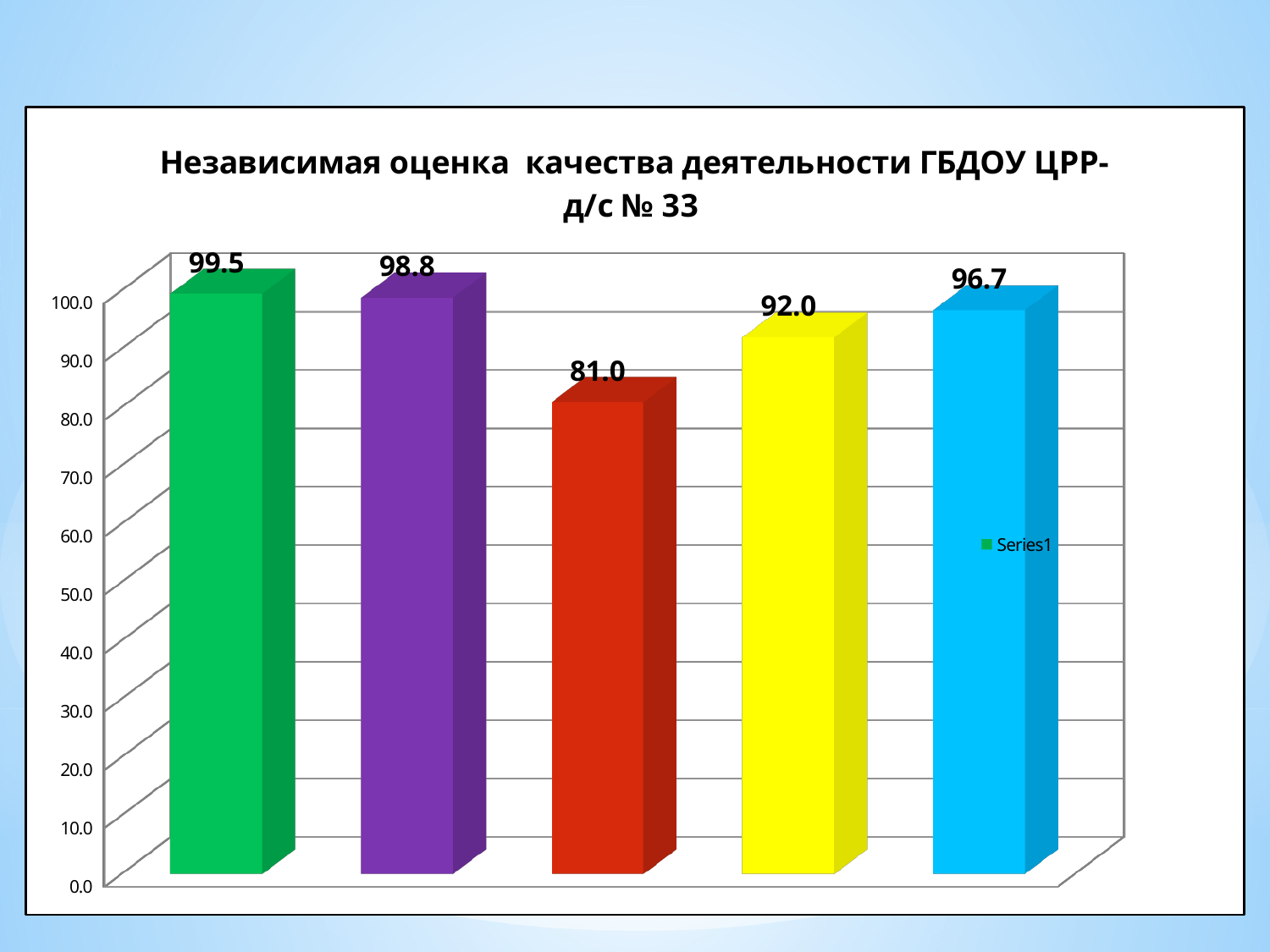
How many bars are plotted in the chart? 5 Which bar has the highest value? the green bar (99.5) What is the value shown on the red bar (third from the left)? 81.0 Which is larger, the yellow bar's value or the blue bar's value? the blue bar (96.7) What entry does the legend list? Series1 What is the difference between the green bar's value and the red bar's value? 18.5 What type of chart is shown on the slide? bar chart What is the value shown on the green bar (first from the left)? 99.5 What is the value shown on the yellow bar (fourth from the left)? 92.0 What is the value shown on the purple bar (second from the left)? 98.8 What is the value shown on the blue bar (fifth from the left)? 96.7 Which bar has the lowest value? the red bar (81.0)